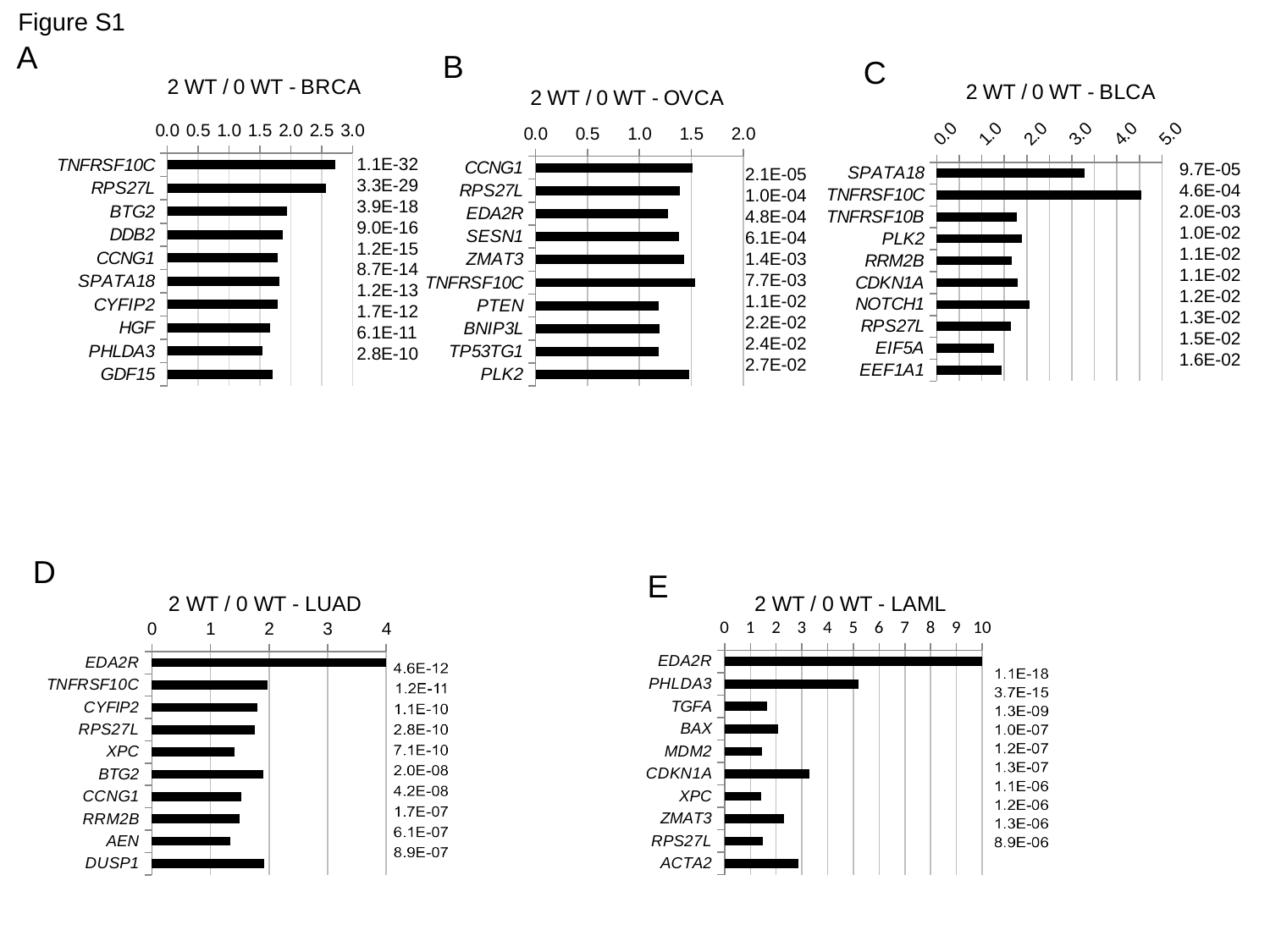
What kind of chart is the one titled "2 WT / 0 WT - OVCA"? Bar chart In the chart titled "2 WT / 0 WT - LAML", which is larger, the value for PHLDA3 or the value for CDKN1A? PHLDA3 In the chart titled "2 WT / 0 WT - BRCA", is the value for TNFRSF10C greater or less than 2.5? greater How many bar charts are shown on the slide? 5 In the chart titled "2 WT / 0 WT - BLCA", which gene has the highest value? TNFRSF10C In the chart titled "2 WT / 0 WT - LUAD", is the value for XPC greater or less than 2? less In the chart titled "2 WT / 0 WT - OVCA", is the value for CCNG1 greater or less than 1.0? greater In the chart titled "2 WT / 0 WT - LUAD", which gene has the highest value? EDA2R In the chart titled "2 WT / 0 WT - BLCA", which is larger, the value for SPATA18 or the value for NOTCH1? SPATA18 In the chart titled "2 WT / 0 WT - BRCA", which gene has the longest bar? TNFRSF10C In the chart titled "2 WT / 0 WT - BRCA", how many genes are plotted? 10